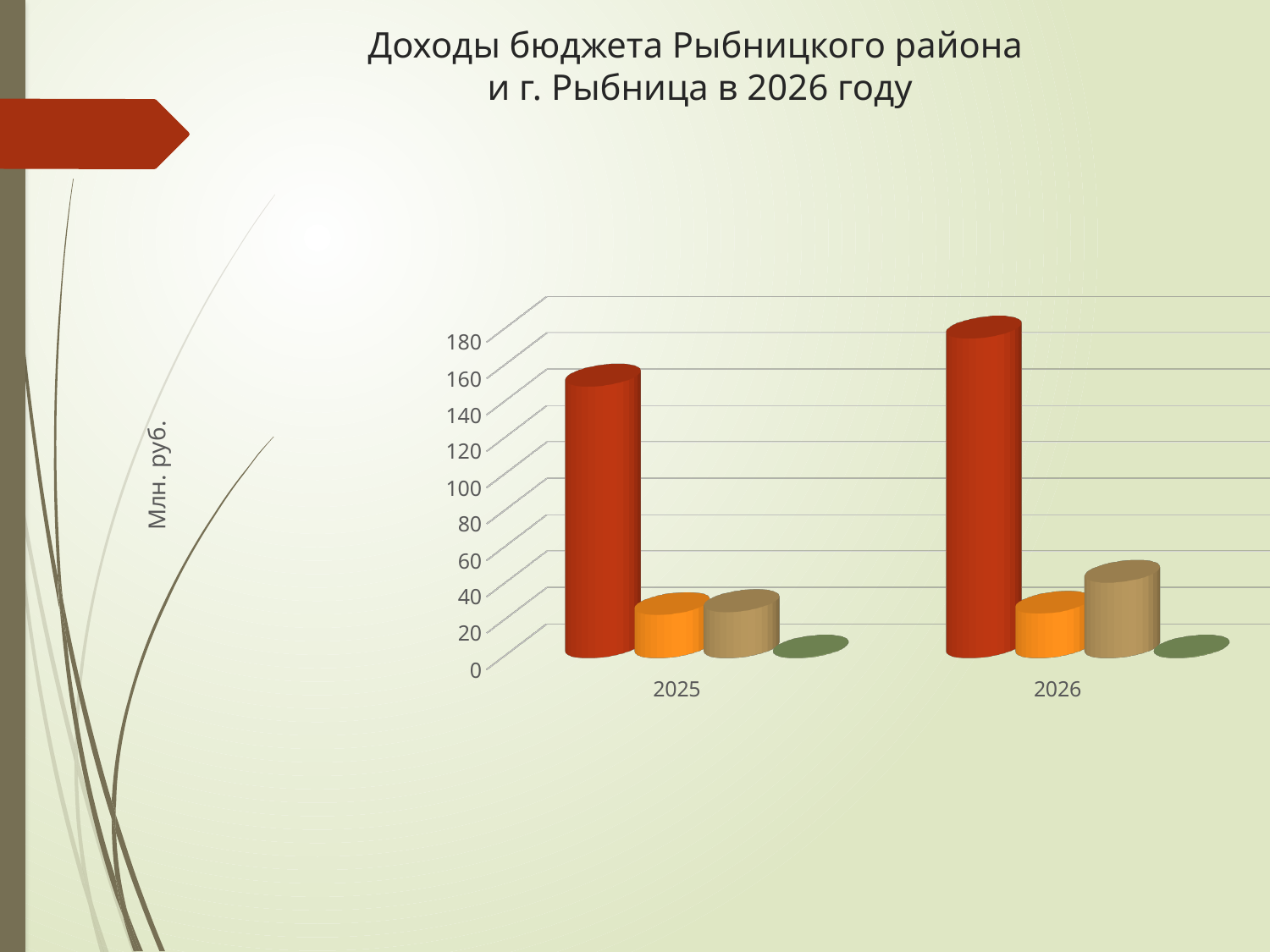
Is the value of the green bar for 2026 greater or less than 20? less What is the label on the vertical axis of the chart? Млн. руб. Does the value of the red bar rise or fall from 2025 to 2026? rise What is the title of the chart on the slide? Доходы бюджета Рыбницкого района и г. Рыбница в 2026 году Is the value of the tan (brown) bar for 2026 greater or less than 80? less Which year has the larger value for the tan (brown) bar, 2025 or 2026? 2026 Which year has the larger value for the red bar, 2025 or 2026? 2026 How many categories are shown on the x axis of the chart? 2 Is the value of the tallest (red) bar for 2025 greater or less than 100? greater What kind of chart is shown on the slide? bar chart